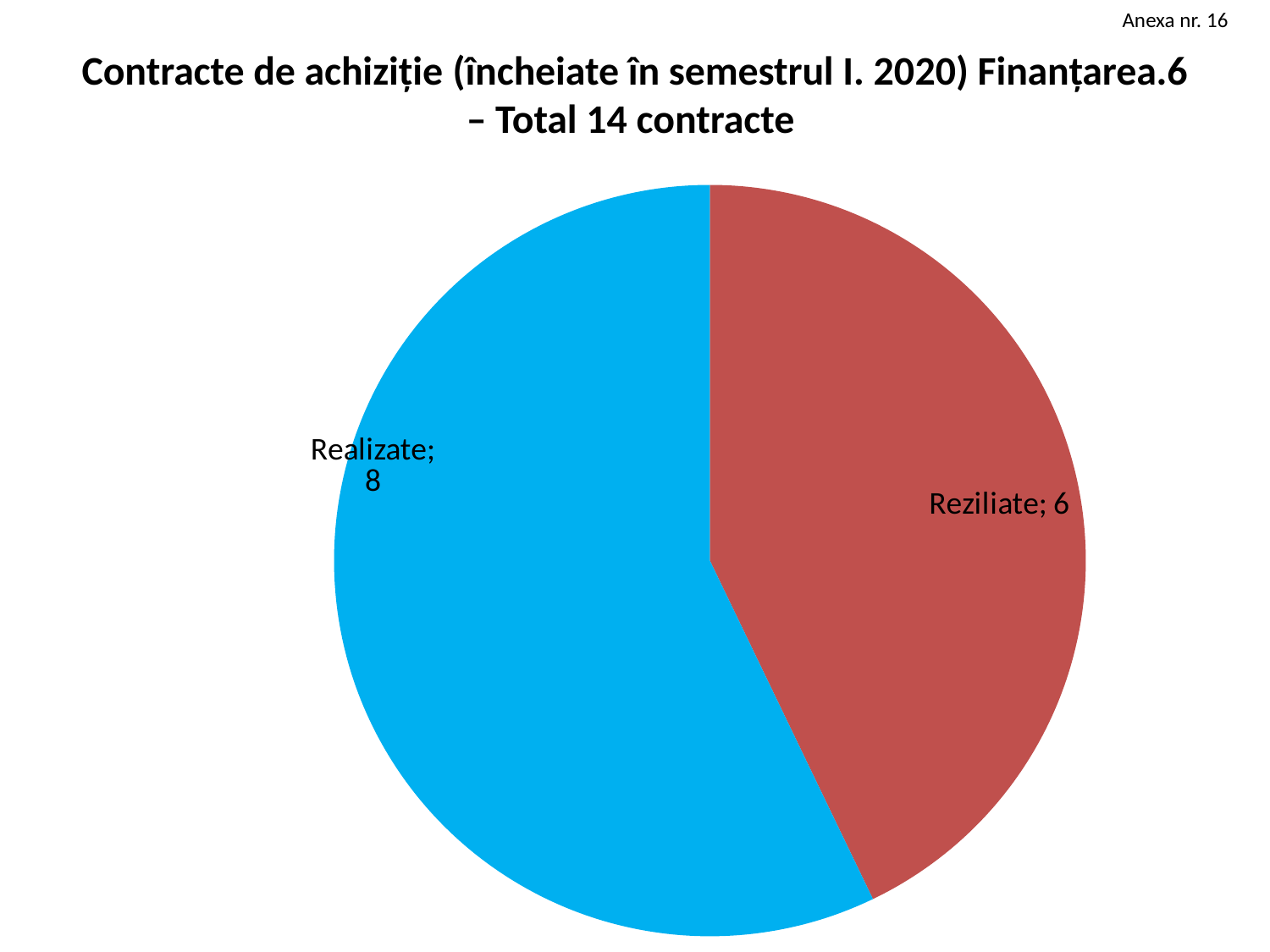
What is the value for Reziliate? 6 What is the title of the chart? Contracte de achiziție (încheiate în semestrul I. 2020) Finanțarea.6 – Total 14 contracte How many slices does the pie chart have? 2 What is the difference between the values for Realizate and Reziliate? 2 What is the value for Realizate? 8 Which slice is the largest? Realizate What is the total of all slices in the pie chart? 14 Which is larger, Realizate or Reziliate? Realizate What kind of chart is shown on the slide? pie chart What colour is the Realizate slice? blue What share of the pie does Reziliate represent? 6/14 Which slice is the smallest? Reziliate